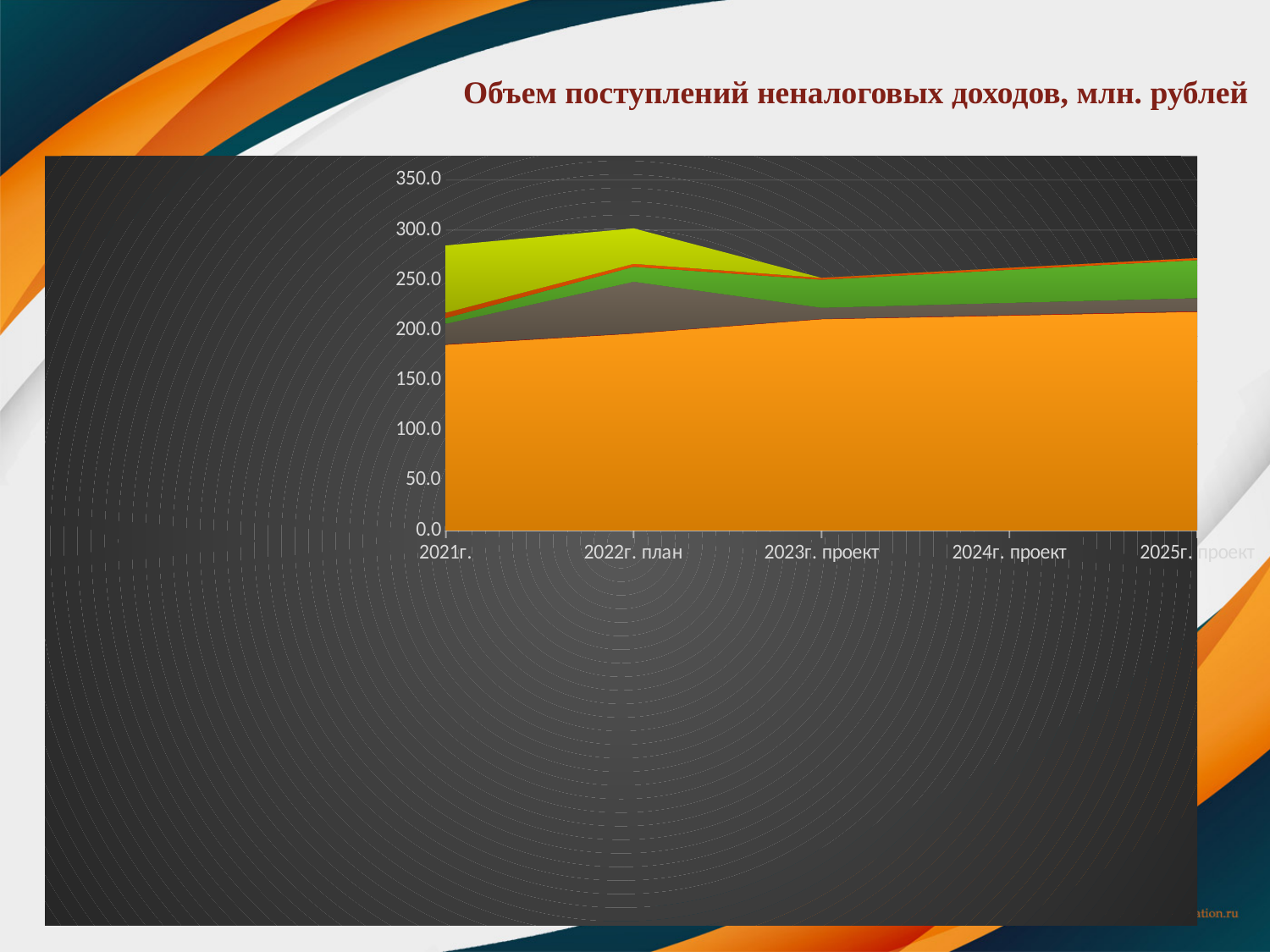
How many categories are shown along the x axis of the chart? 5 Is the value of the bottom orange series for 2021г. greater or less than 200? less What is the highest value shown on the y axis of the chart? 350.0 Is the total stacked value for 2022г. план greater or less than 250? greater Is the total stacked value for 2025г. проект greater or less than 300? less What is the title of the chart? Объем поступлений неналоговых доходов, млн. рублей What kind of chart is shown on the slide? area chart In which category does the top of the stacked area reach its highest point? 2022г. план Is the total stacked value for 2022г. план larger or smaller than the total for 2023г. проект? larger Does the bottom orange series rise or fall from 2021г. to 2025г. проект? rise